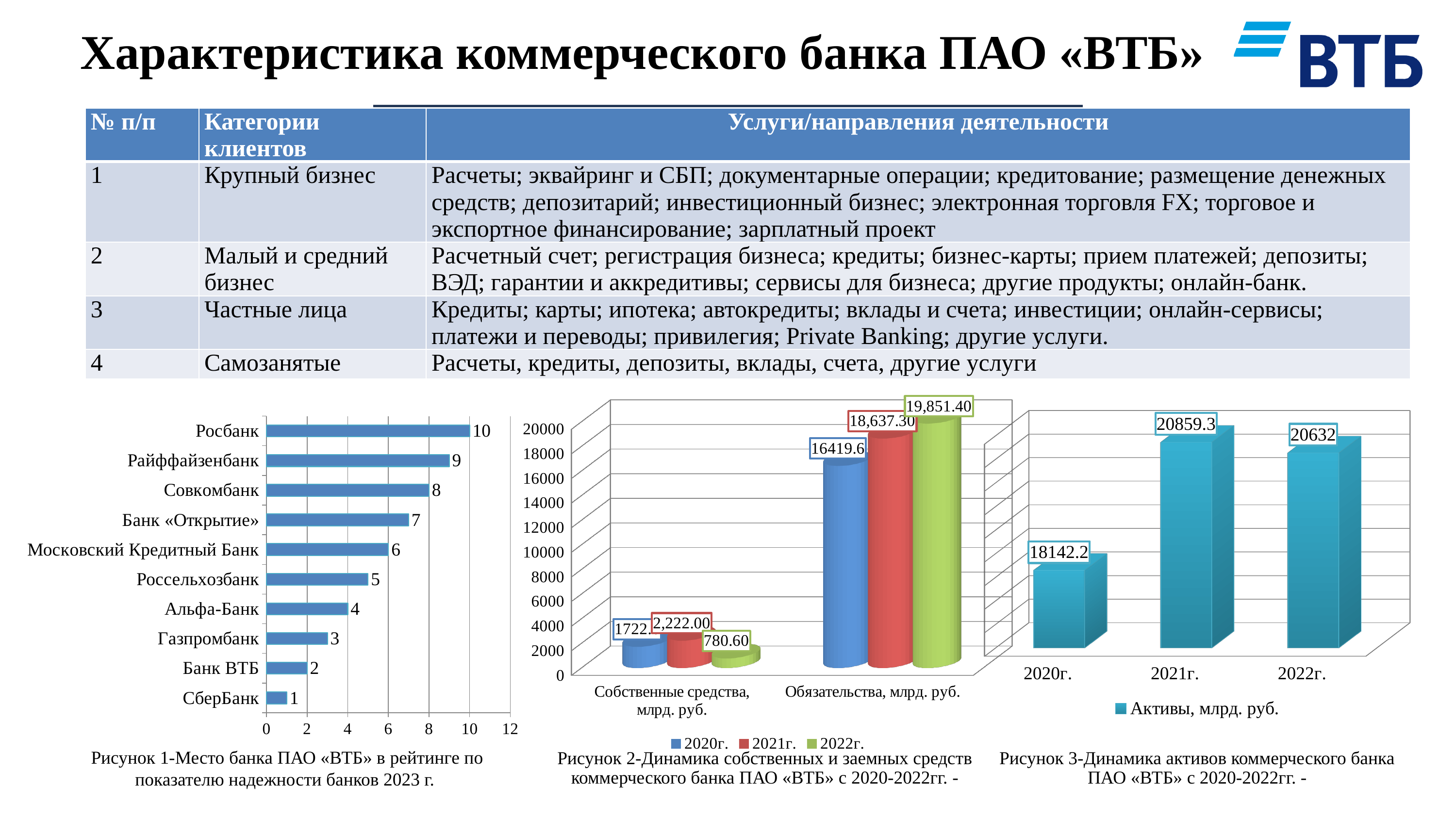
In the chart 'Рисунок 2' (middle), is the value of Обязательства for 2020г. greater or less than 16000? greater In the chart 'Рисунок 1' (left), which bank has the lowest value? СберБанк In the chart 'Рисунок 1' (left), which bank has the highest value? Росбанк In the chart 'Рисунок 3' (right), what is the value of Активы, млрд. руб. for 2020г.? 18142.2 In the chart 'Рисунок 3' (right), which year has the highest value of Активы? 2021г. In the chart 'Рисунок 2' (middle), how many series does the legend list? 3 What type of chart is 'Рисунок 1' (left)? Bar chart In the chart 'Рисунок 1' (left), what value is shown for Банк ВТБ? 2 In the chart 'Рисунок 2' (middle), what is the value of Обязательства, млрд. руб. for 2022г.? 19,851.40 In the chart 'Рисунок 1' (left), what is the difference between the values for Совкомбанк and Газпромбанк? 5 In the chart 'Рисунок 2' (middle), what is the value of Собственные средства, млрд. руб. for 2021г.? 2,222.00 In the chart 'Рисунок 1' (left), how many banks are listed? 10